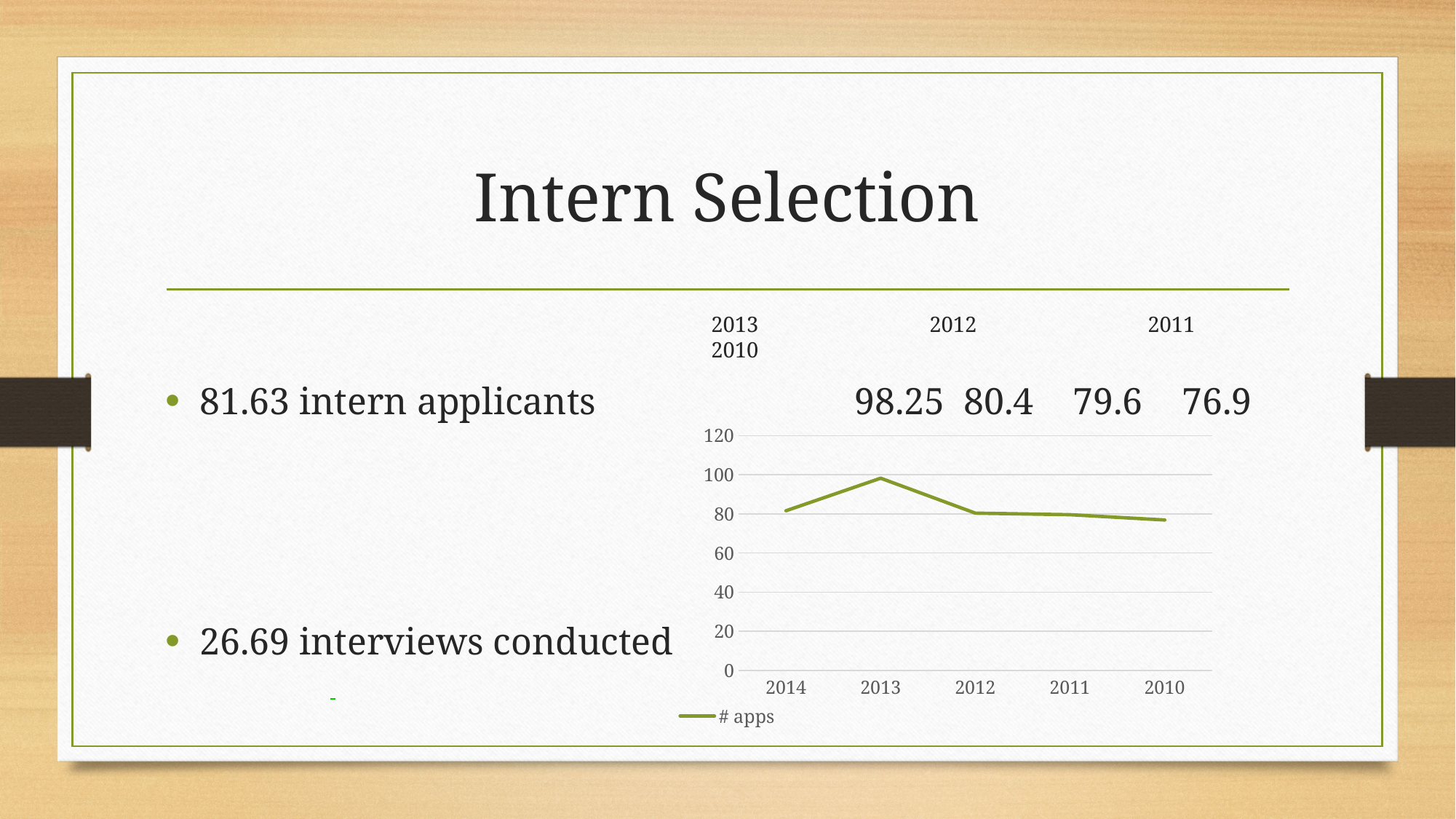
How many series does the chart legend list? 1 Which year has the highest value for # apps? 2013 What kind of chart is shown on the slide? line chart What is the value for # apps in 2013? 98.25 How many years are plotted along the x axis of the chart? 5 Which year has the lowest value for # apps? 2010 Is the value for # apps in 2014 greater or less than 100? less What is the value for # apps in 2010? 76.9 What is the difference between the # apps values for 2013 and 2012? 17.85 Which is larger, the # apps value for 2013 or for 2012? 2013 Do the # apps values rise or fall from 2013 to 2010 along the x axis? fall What is the name of the series shown in the chart legend? # apps